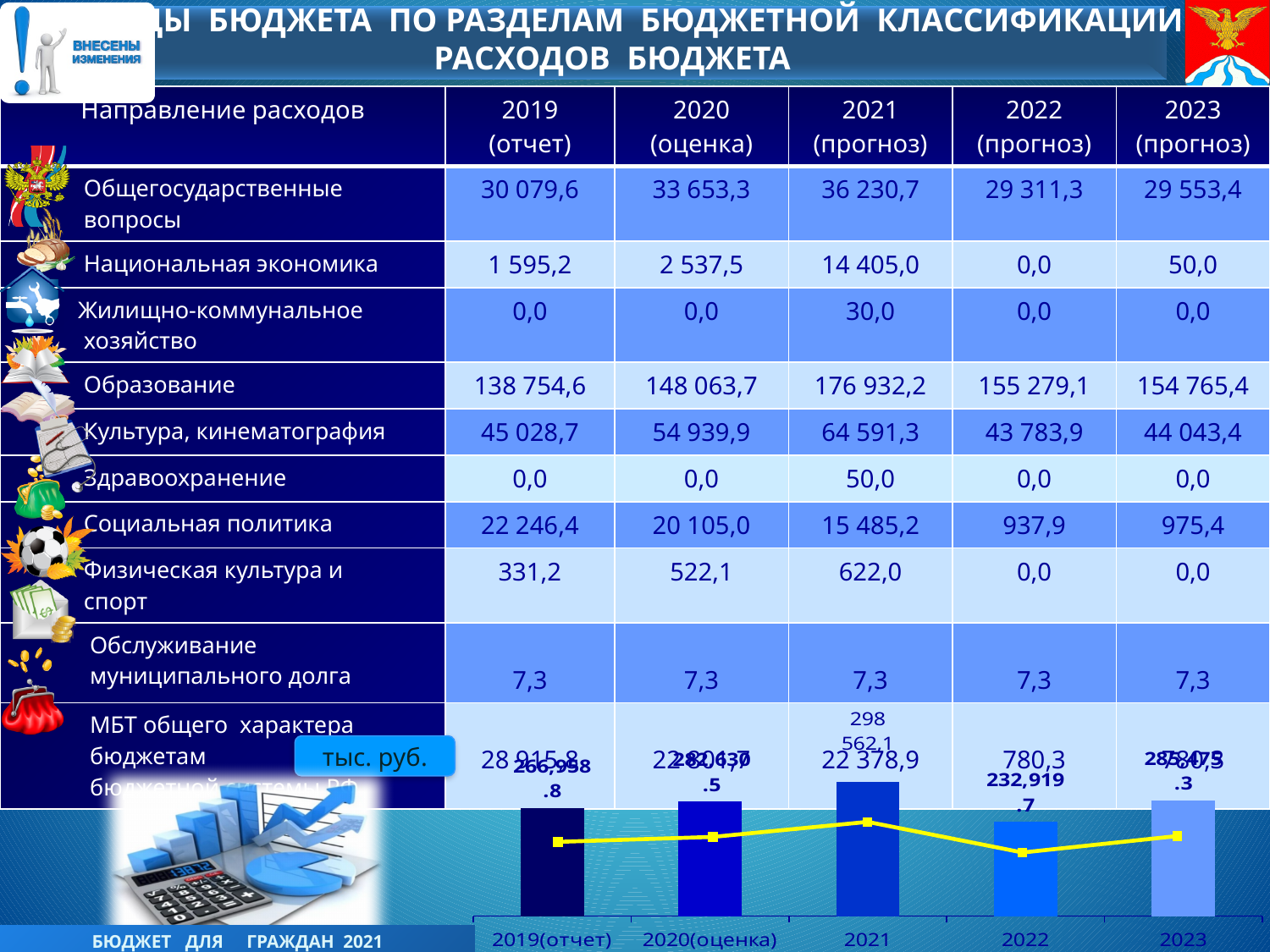
In the chart at the bottom of the slide, which category has the tallest bar? 2021 In the chart at the bottom of the slide, what is the data label for 2021? 298 562,1 What colour is the line plotted over the bars in the chart at the bottom of the slide? yellow What kind of chart is shown at the bottom of the slide? bar chart with a line In the chart at the bottom of the slide, which is larger, the bar for 2019(отчет) or the bar for 2022? 2019(отчет) In the chart at the bottom of the slide, does the yellow line rise or fall from 2021 to 2022? fall In the chart at the bottom of the slide, what is the data label for 2022? 232,919.7 In the chart at the bottom of the slide, what is the data label for 2019(отчет)? 266,958.8 In the chart at the bottom of the slide, which category has the shortest bar? 2022 In the chart at the bottom of the slide, what is the difference between the values for 2019(отчет) and 2022? 34,039.1 How many categories are shown on the x axis of the chart at the bottom of the slide? 5 In the chart at the bottom of the slide, which is larger, the bar for 2021 or the bar for 2022? 2021